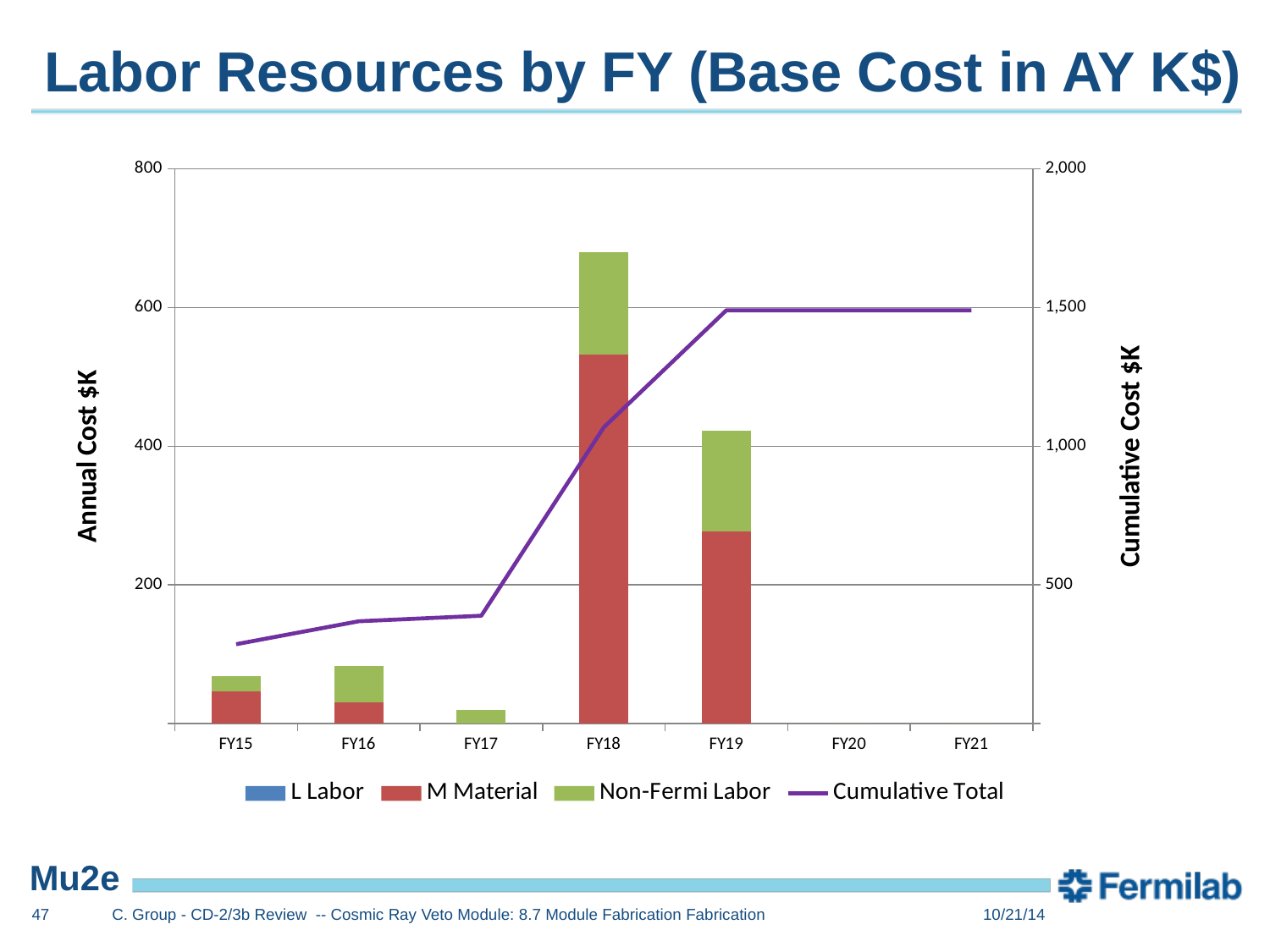
What is the label of the right-hand vertical axis? Cumulative Cost $K Is the Cumulative Total value at FY18 greater or less than 500? greater Which fiscal year has the tallest stacked bar for annual cost? FY18 What kind of chart is shown on the slide? A stacked bar chart combined with a line chart Is the annual cost bar for FY17 greater or less than 200? less What is the title of the chart? Labor Resources by FY (Base Cost in AY K$) Which stacked bar is taller, FY18 or FY19? FY18 Is the total annual cost bar for FY18 greater or less than 600? greater How many fiscal years are shown on the x axis of the chart? 7 Does the Cumulative Total line rise or fall from FY15 to FY19? rise How many series does the chart's legend list? 4